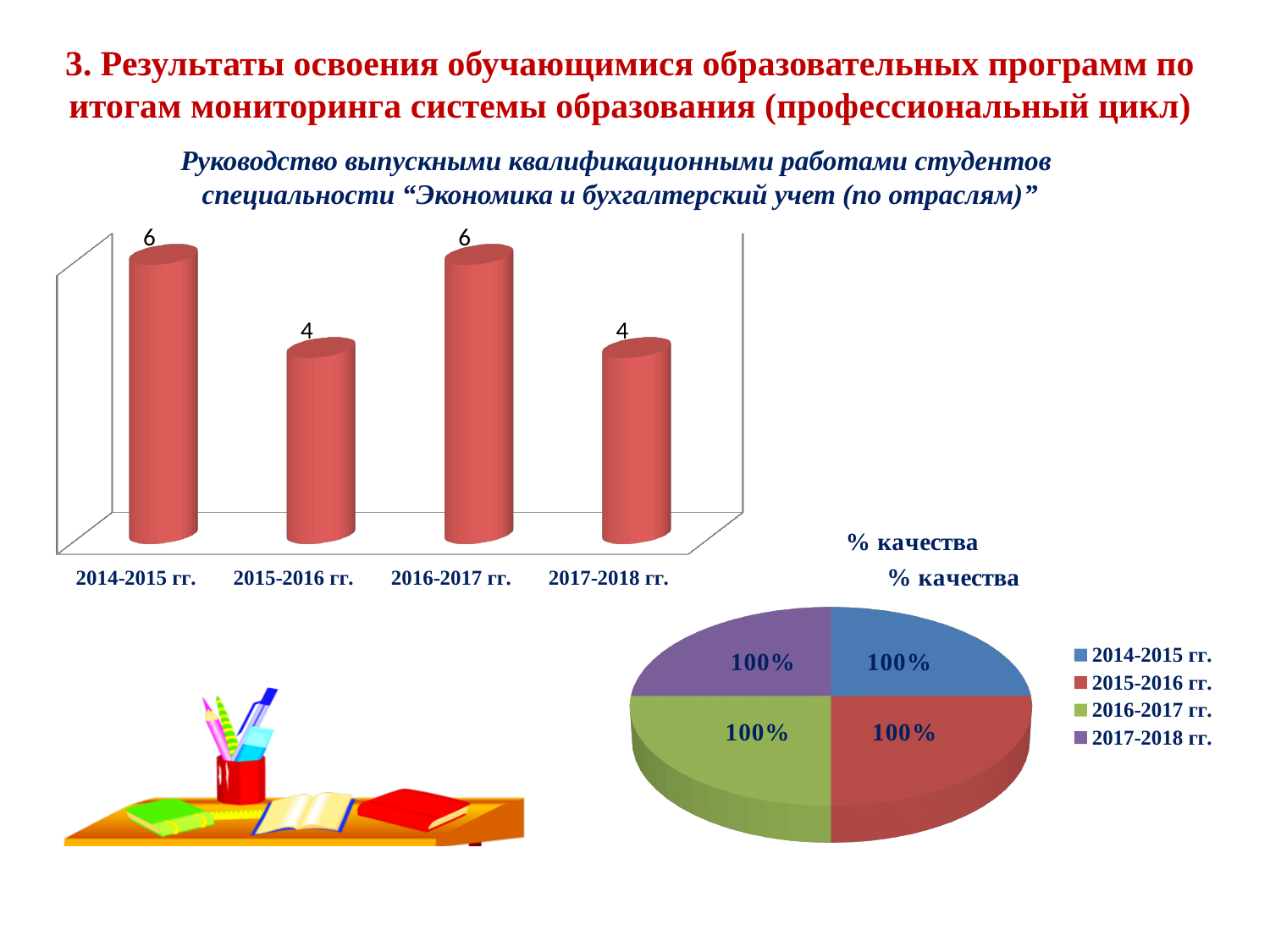
In the bar chart, what is the difference between the values for 2016-2017 гг. and 2017-2018 гг.? 2 How many categories are shown in the bar chart? 4 In the bar chart, what is the value for 2014-2015 гг.? 6 What kind of chart is the chart at the bottom right of the slide? pie chart How many slices does the pie chart titled "% качества" have? 4 How many entries does the legend of the pie chart list? 4 In the bar chart, which is larger: the value for 2014-2015 гг. or the value for 2015-2016 гг.? 2014-2015 гг. What kind of chart is the chart at the top left of the slide? bar chart In the pie chart titled "% качества", what is the value shown for 2016-2017 гг.? 100% In the bar chart, what is the value for 2017-2018 гг.? 4 In the bar chart, what is the value for 2015-2016 гг.? 4 What is the title of the chart at the bottom right of the slide? % качества